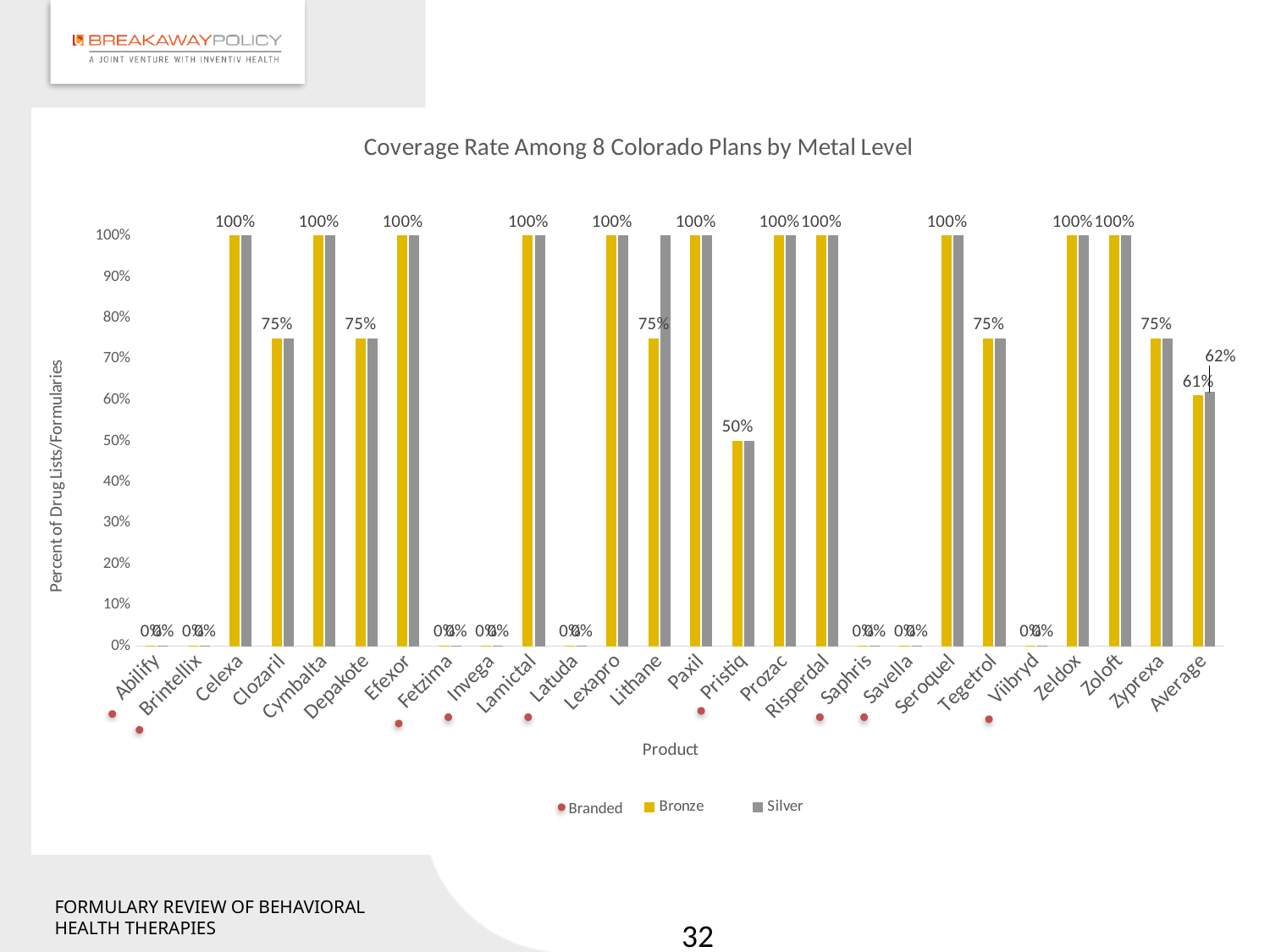
How many series does the legend list? 3 Which has a higher Bronze coverage rate, Zyprexa or Pristiq? Zyprexa What kind of chart is shown on the slide? bar chart What is the Bronze coverage rate for Pristiq? 50% What is the title of the y axis? Percent of Drug Lists/Formularies Among Clozaril, Pristiq and Zoloft, which product has the lowest Bronze coverage rate? Pristiq Is the Silver coverage rate for Lithane greater or less than 90%? greater What is the Bronze coverage rate for the Average category? 61% What is the Bronze coverage rate for Clozaril? 75% What is the Silver coverage rate for the Average category? 62% What is the difference between the Bronze coverage rate for Celexa and the Bronze coverage rate for Pristiq? 50% How many products (categories) are shown on the x axis, including Average? 26